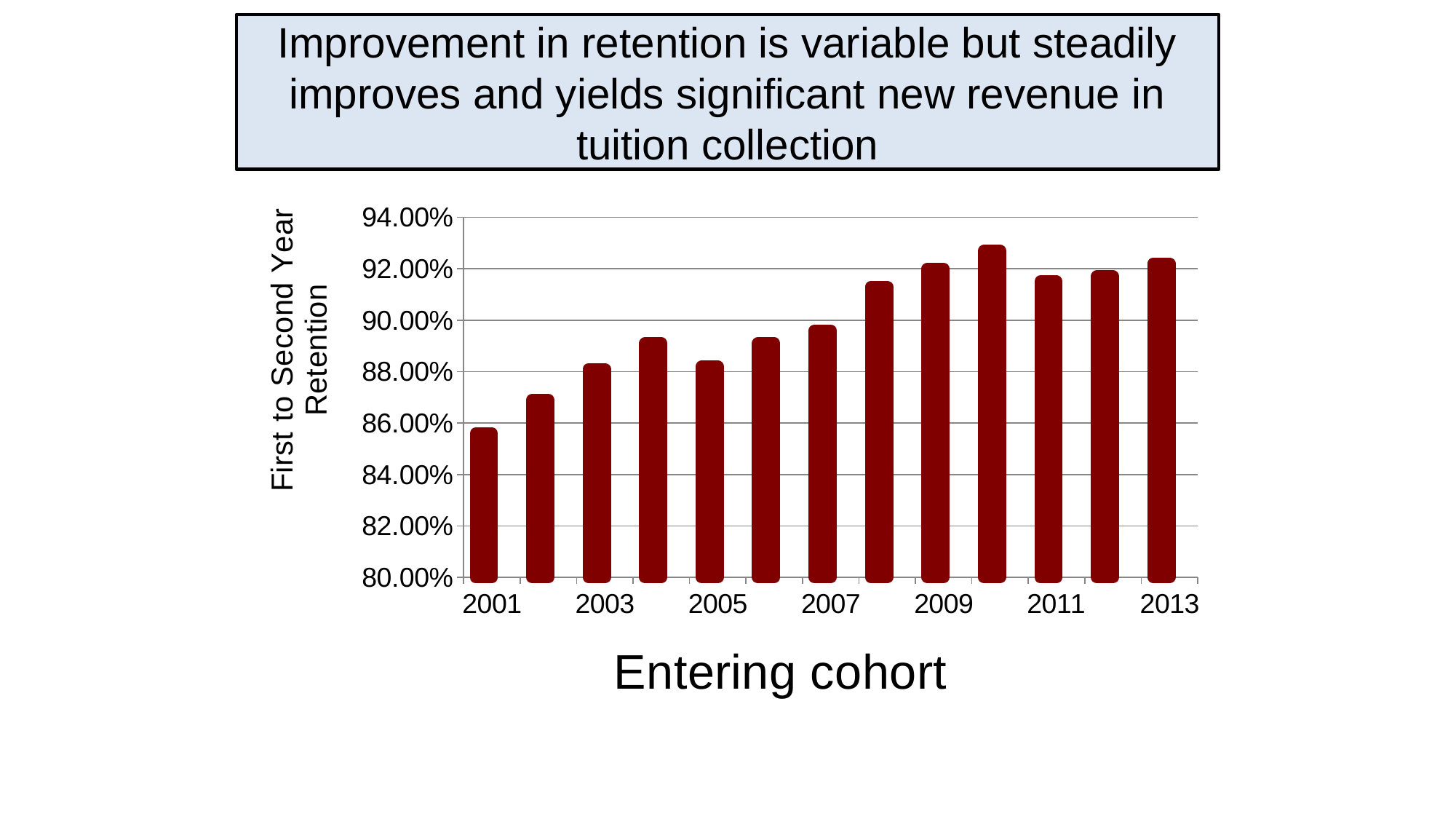
How many entering cohorts (bars) are plotted in the chart? 13 Which entering cohort has the highest first to second year retention? 2010 What is the label on the vertical axis of the chart? First to Second Year Retention Is the retention value for the 2001 cohort greater or less than 86.00%? less Which cohort has higher retention, 2003 or 2009? 2009 Which cohort has higher retention, 2005 or 2013? 2013 Is the retention value for the 2008 cohort greater or less than 90.00%? greater What kind of chart is shown on the slide? bar chart Is the retention value for the 2007 cohort greater or less than 90.00%? less Which entering cohort has the lowest first to second year retention? 2001 Overall, do retention values rise or fall from the 2001 cohort to the 2013 cohort? rise